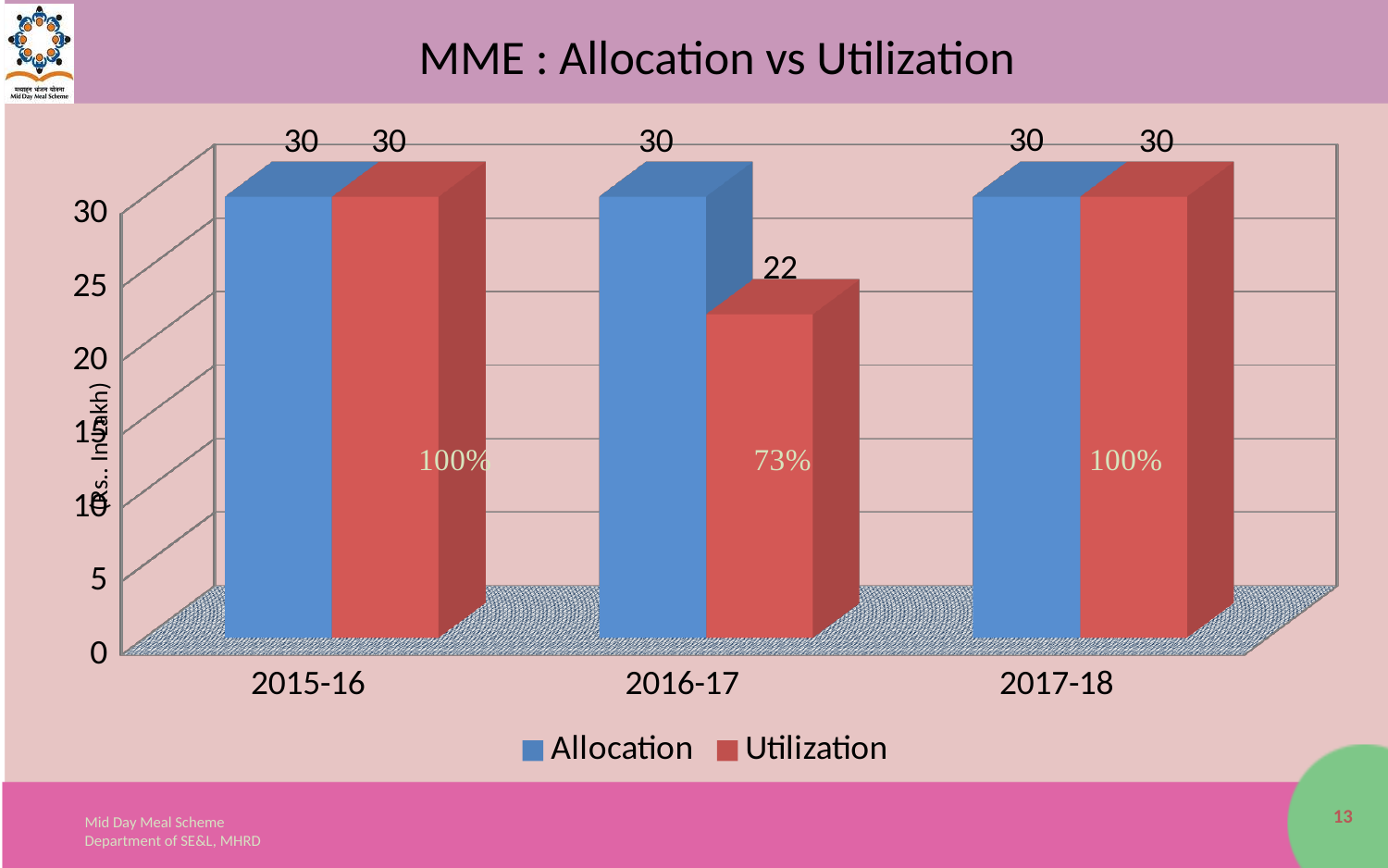
How many years are shown on the x axis? 3 What is the title of the chart? MME : Allocation vs Utilization Is the Utilization value for 2016-17 greater or less than 25? less What kind of chart is shown on the slide? bar chart What is the Utilization value for 2016-17? 22 What is the Allocation value for 2015-16? 30 What is the difference between Allocation and Utilization in 2016-17? 8 How many series does the legend list? 2 Which is larger in 2016-17, Allocation or Utilization? Allocation Which year has the lowest Utilization value? 2016-17 What is the Utilization value for 2017-18? 30 What percentage label is shown for 2016-17? 73%